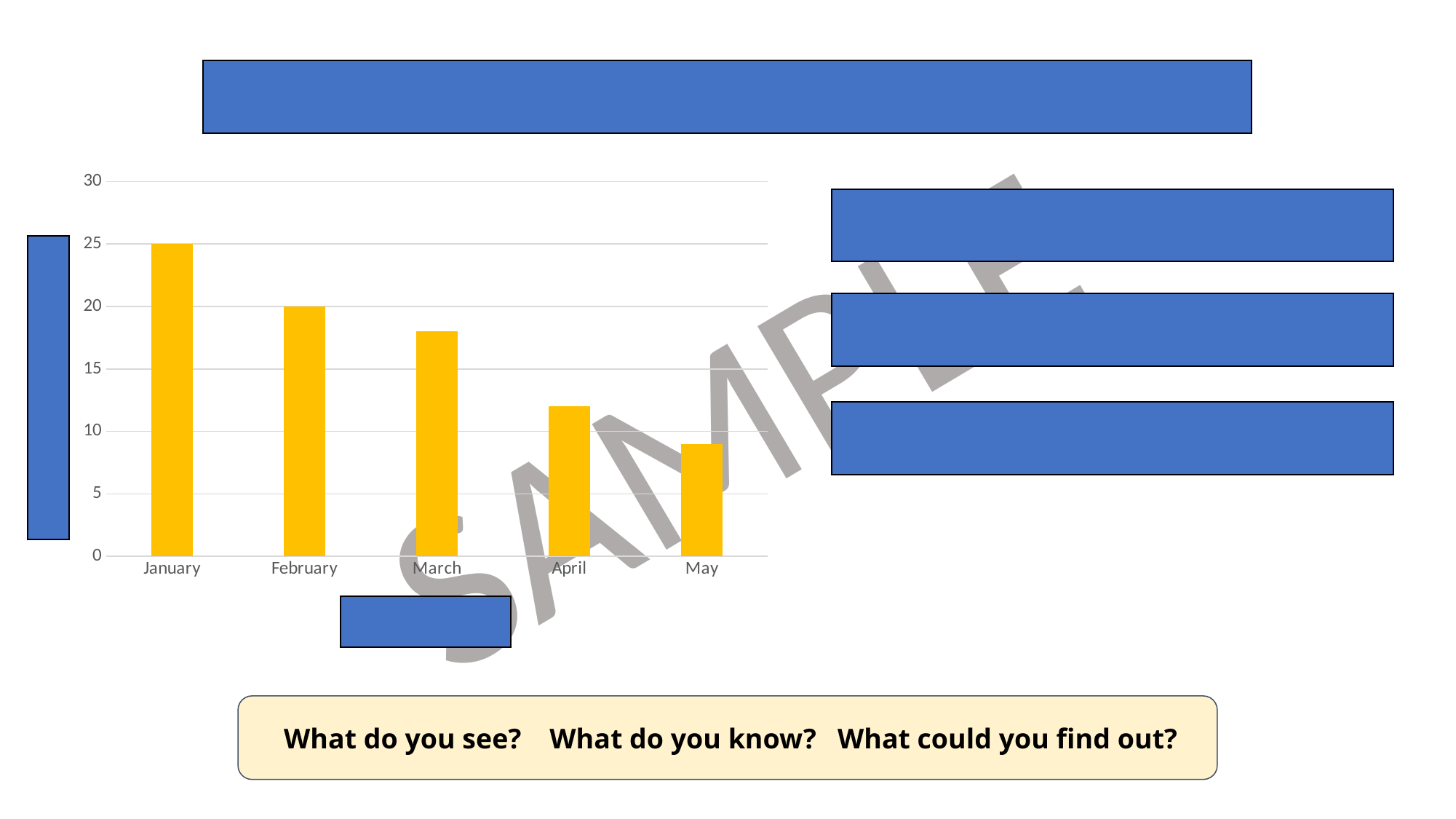
Which month has the highest value? January What is the value for February? 20 What is the difference between the values for January and February? 5 Is the value for March greater or less than 15? greater Is the value for April greater or less than 15? less What type of chart is shown on the slide? bar chart How many categories are shown on the x axis of the chart? 5 Do the values rise or fall from January to May? fall Is the value for May greater or less than 10? less Which is larger, the value for March or the value for April? March Which month has the lowest value? May What is the value for January? 25